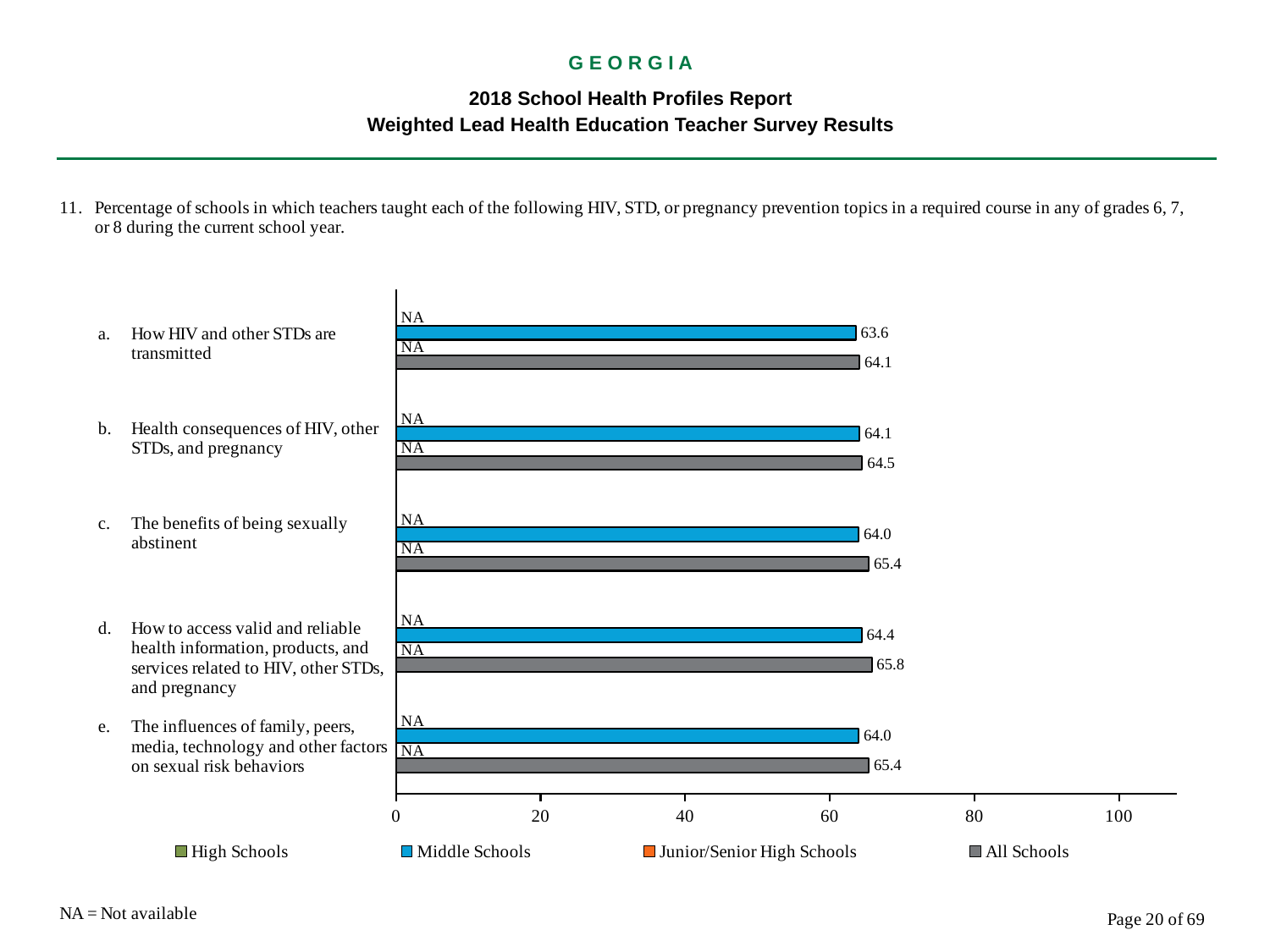
Which topic has the lowest Middle Schools value? How HIV and other STDs are transmitted What type of chart is shown on the slide? bar chart Which series is shown in blue in the legend? Middle Schools How many series does the legend list? 4 What is the difference between the All Schools and Middle Schools values for 'The influences of family, peers, media, technology and other factors on sexual risk behaviors'? 1.4 What is the All Schools value for 'How to access valid and reliable health information, products, and services related to HIV, other STDs, and pregnancy'? 65.8 Is the Middle Schools value for 'Health consequences of HIV, other STDs, and pregnancy' greater or less than 60? greater Which topic has the highest All Schools value? How to access valid and reliable health information, products, and services related to HIV, other STDs, and pregnancy What is the All Schools value for 'The benefits of being sexually abstinent'? 65.4 How many topics (categories) are plotted on the chart? 5 What value is shown for High Schools for 'Health consequences of HIV, other STDs, and pregnancy'? NA What is the Middle Schools value for 'How HIV and other STDs are transmitted'? 63.6